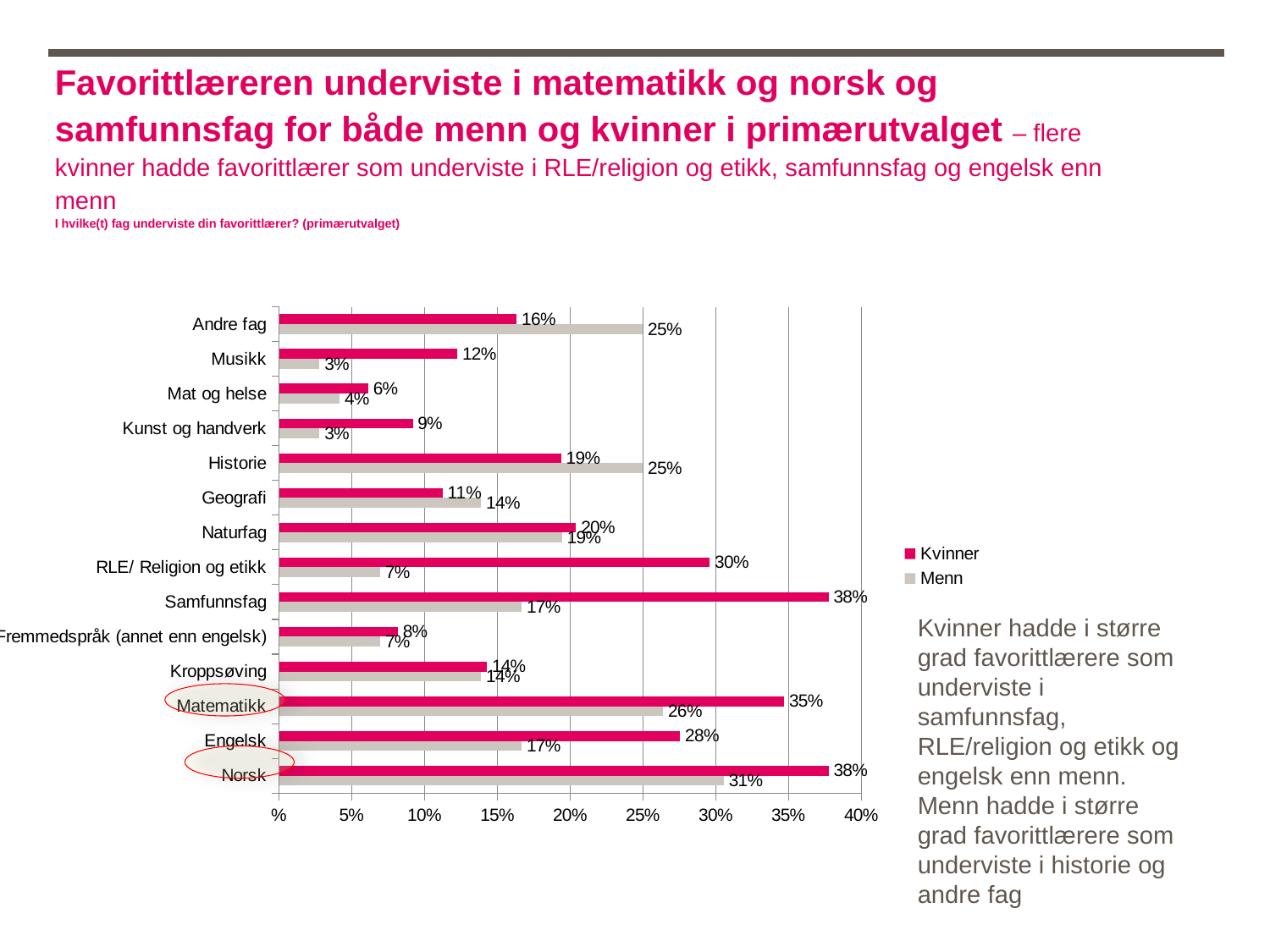
What is the value for Menn for Matematikk? 26% What is the difference between the Kvinner and Menn values for Samfunnsfag? 21% Which category has the lowest value for Kvinner? Mat og helse Which category has the highest value for Menn? Norsk For Historie, which is larger: the value for Kvinner or the value for Menn? Menn What is the value for Menn for Andre fag? 25% Which series is shown in pink in the legend? Kvinner What type of chart is shown on the slide? bar chart What is the value for Kvinner for RLE/ Religion og etikk? 30% Is the Kvinner value for Engelsk greater or less than 25%? greater How many subject categories are plotted on the chart? 14 How many series does the legend list? 2